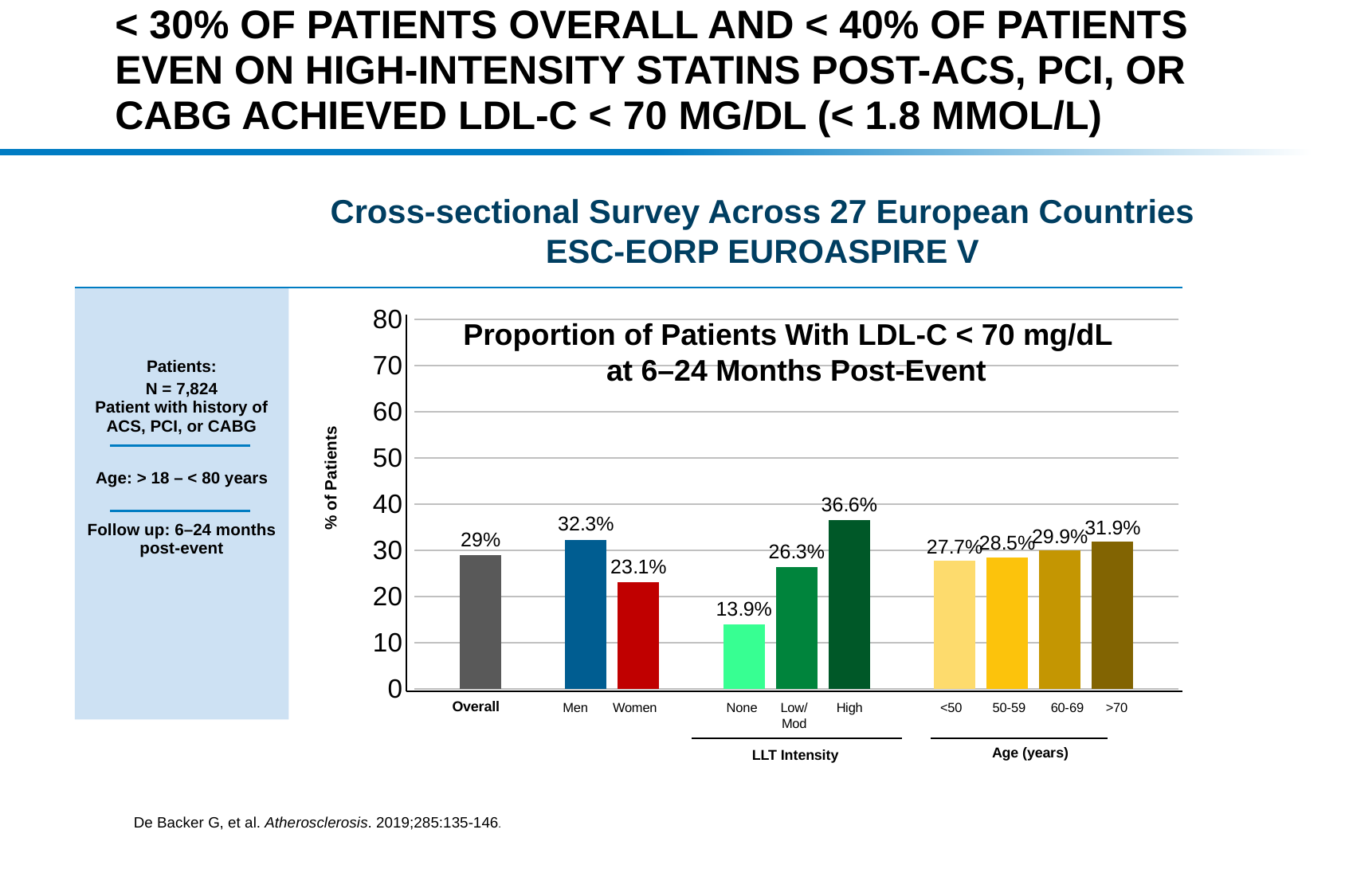
What is the difference between the High and None LLT intensity groups? 22.7% What is the difference between the values for Men and Women? 9.2% What kind of chart is shown on the slide? Bar chart Which category has the lowest proportion of patients with LDL-C < 70 mg/dL? None What is the value shown for the High LLT intensity group? 36.6% What is the value shown for patients aged 60-69? 29.9% Is the value for the Low/Mod LLT intensity group greater or less than 30? less Do the values rise or fall across the age groups from <50 to >70? Rise How many bars are plotted in the chart? 10 Which category has the highest proportion of patients with LDL-C < 70 mg/dL? High What percentage of patients overall achieved LDL-C < 70 mg/dL at 6–24 months post-event? 29% Which is larger, the value for patients aged <50 or patients aged >70? >70